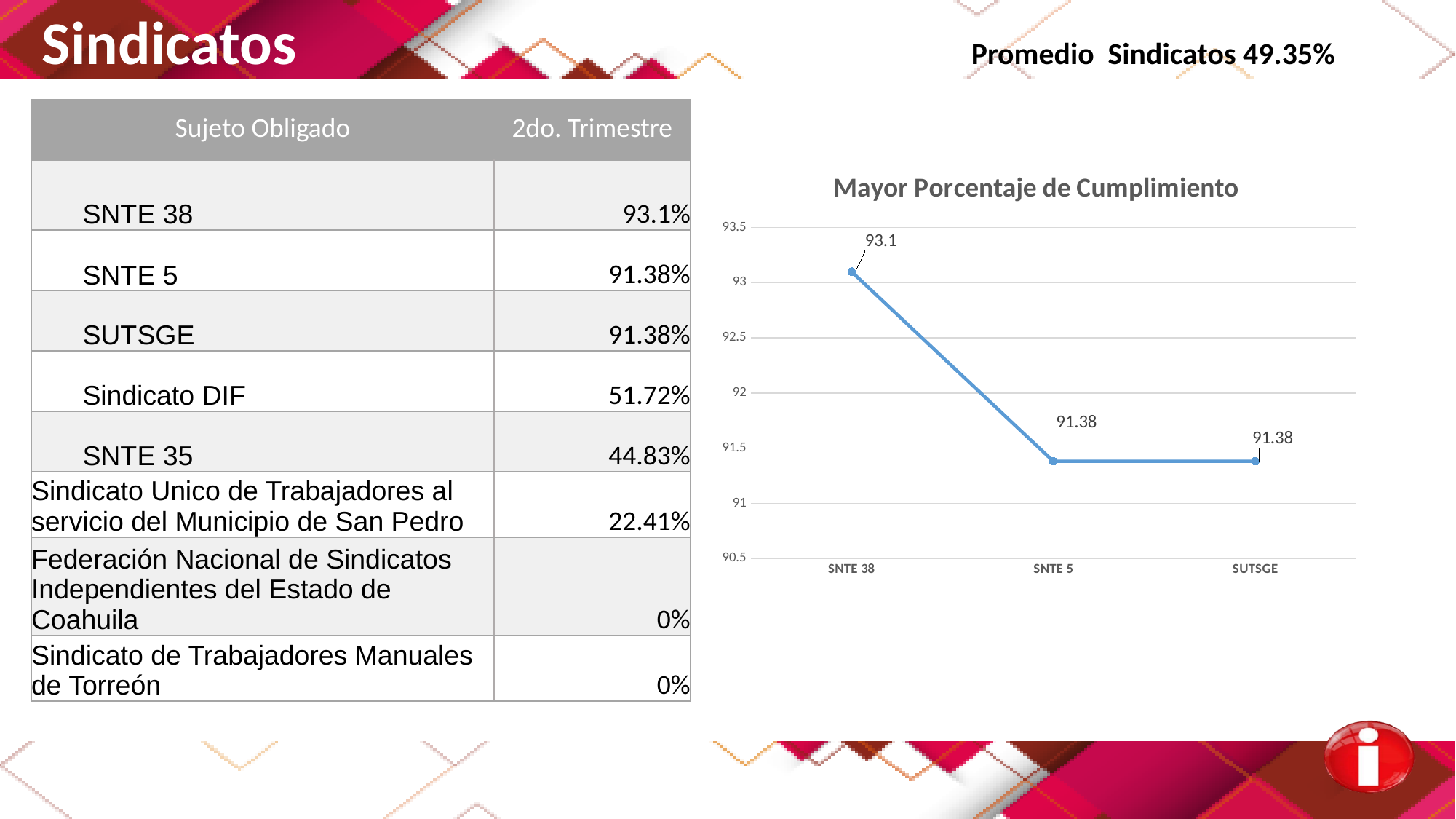
Which is larger, the value for SNTE 38 or the value for SUTSGE? SNTE 38 What is the value for SUTSGE in the chart? 91.38 Is the value for SNTE 38 greater or less than 92.5? greater What type of chart is shown on the slide? line chart What is the value for SNTE 5 in the chart? 91.38 What is the value for SNTE 38 in the chart? 93.1 Do the values rise or fall from SNTE 38 to SNTE 5 along the x axis? fall How many categories are plotted on the x axis of the chart? 3 What is the title of the chart? Mayor Porcentaje de Cumplimiento Which category has the highest value in the chart? SNTE 38 Is the value for SNTE 5 greater or less than 92? less What is the difference between the values for SNTE 38 and SNTE 5? 1.72